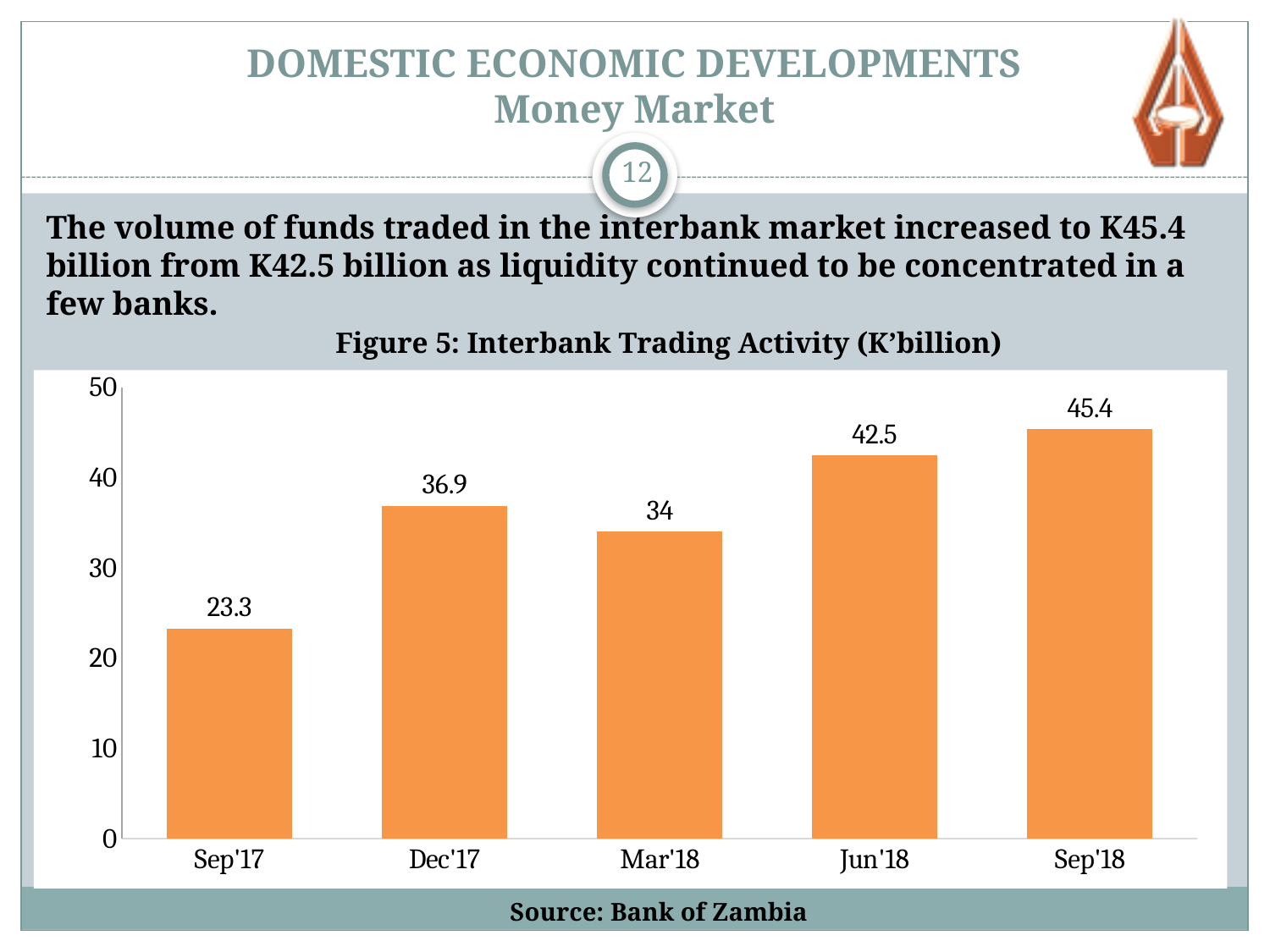
What is the value for Mar'18? 34 How many periods are shown on the x axis? 5 Which period has the lowest value? Sep'17 Which is larger, the value for Dec'17 or the value for Mar'18? Dec'17 What kind of chart is shown? bar chart Is the value for Sep'17 greater or less than 30? less What is the title of the chart? Figure 5: Interbank Trading Activity (K'billion) What is the value for Sep'17? 23.3 What is the value for Dec'17? 36.9 Which period has the highest value? Sep'18 What is the value for Jun'18? 42.5 What is the difference between the values for Sep'18 and Jun'18? 2.9